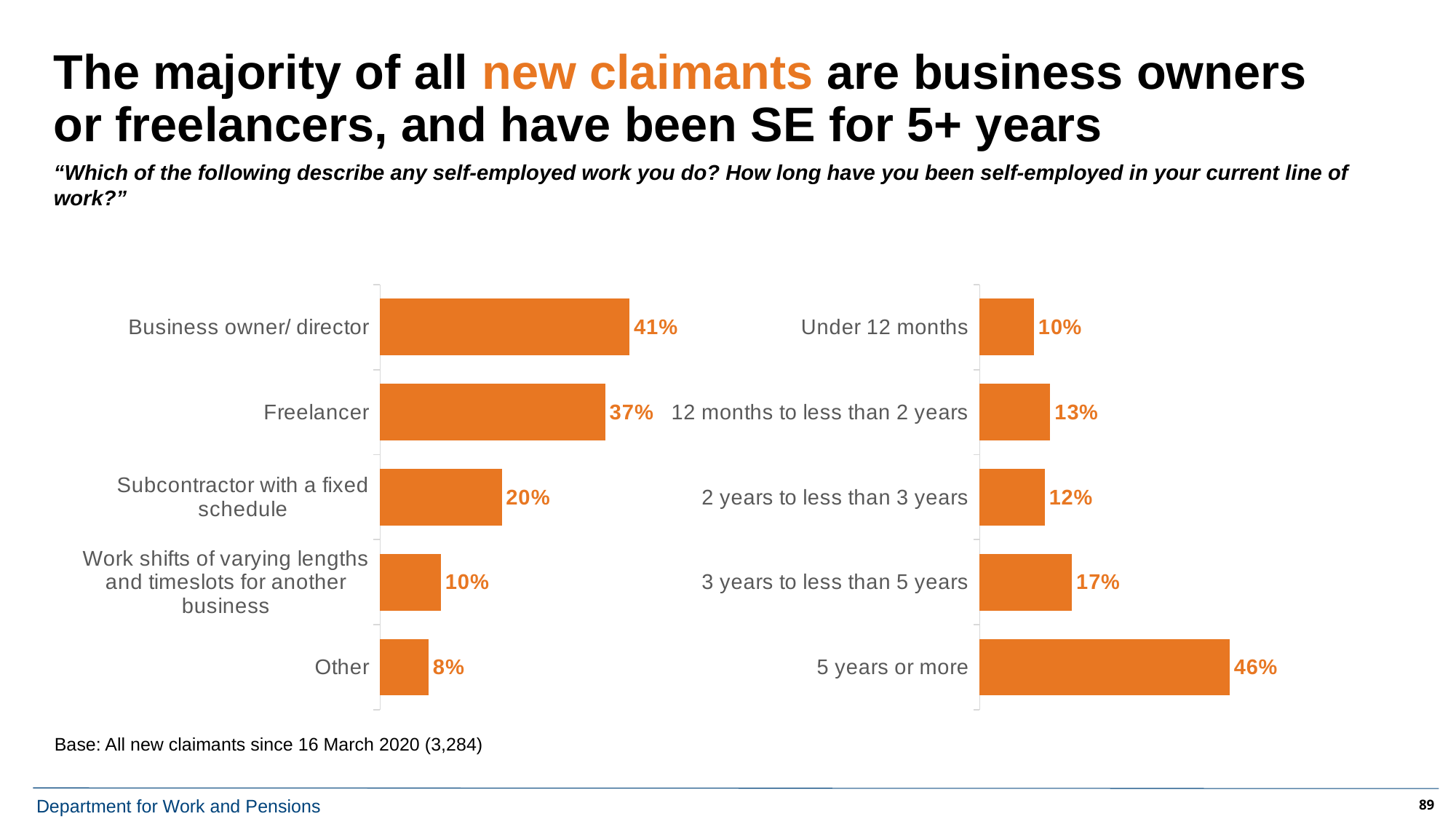
In the left chart, which category has the lowest value? Other What type of chart is the left chart? Bar chart In the right chart, which category has the lowest value? Under 12 months In the left chart, which is larger: Subcontractor with a fixed schedule or Other? Subcontractor with a fixed schedule In the right chart, which category has the highest value? 5 years or more How many categories are shown in the right chart? 5 In the left chart, what is the difference between Business owner/ director and Freelancer? 4% In the left chart, what is the value for Freelancer? 37% In the right chart, what is the value for 3 years to less than 5 years? 17% In the right chart, what is the difference between 5 years or more and Under 12 months? 36% In the right chart, what percentage have been self-employed for 5 years or more? 46% In the left chart, what percentage of new claimants are business owners/directors? 41%